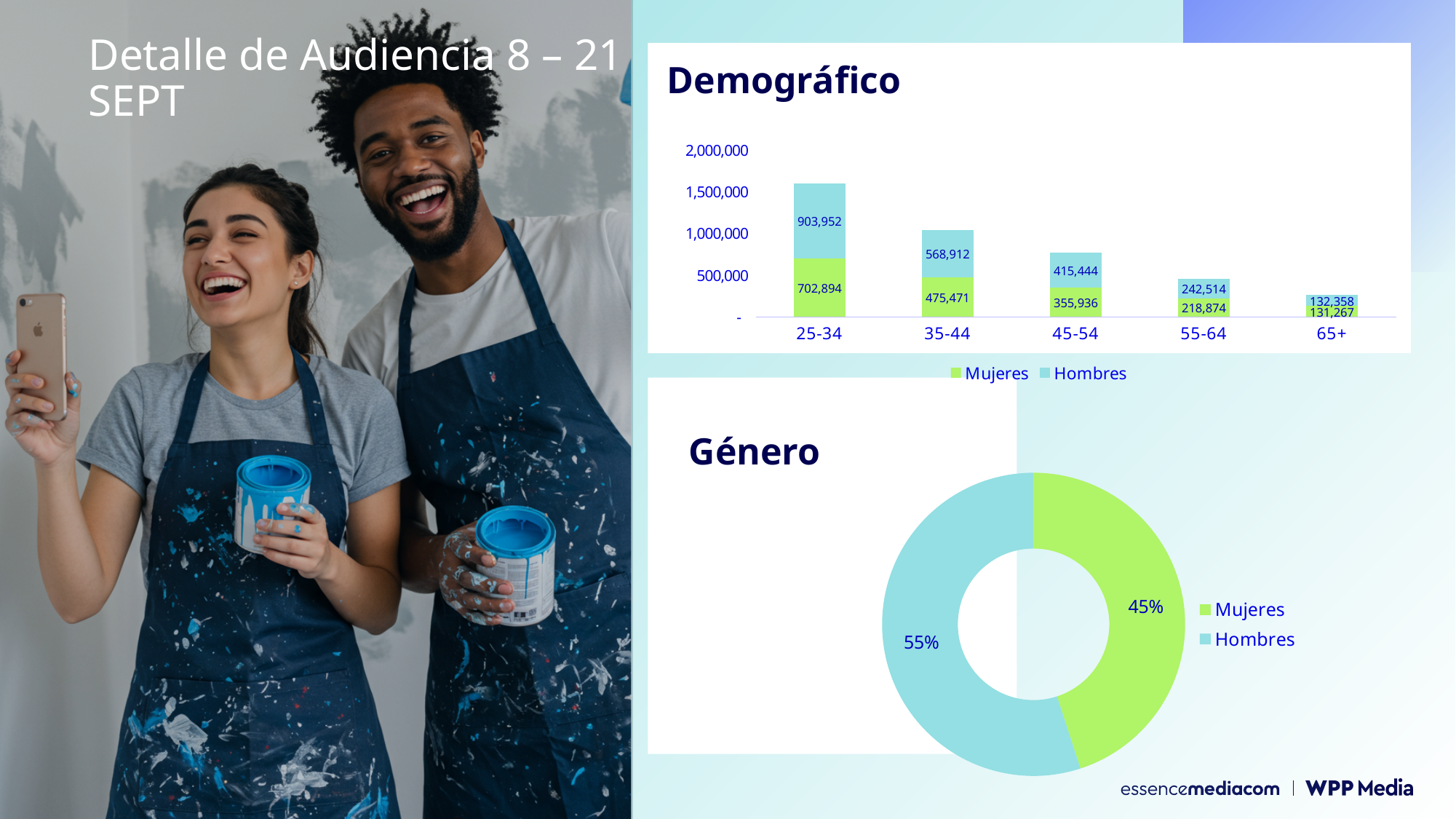
In the Demográfico chart, which age group has the lowest Hombres value? 65+ In the Demográfico chart, what is the total of the stacked bar for the 55-64 age group? 461,388 What kind of chart is the Género chart? Donut chart How many series does the legend of the Demográfico chart list? 2 In the Demográfico chart, what is the difference between the Hombres and Mujeres values for the 35-44 age group? 93,441 In the Demográfico chart, how many age groups are shown on the x axis? 5 In the Demográfico chart, do the stacked bar totals rise or fall as the age groups increase along the x axis? fall In the Demográfico chart, is the Hombres value for 45-54 larger or smaller than the Mujeres value for 35-44? smaller In the Demográfico chart, what is the Hombres value for the 25-34 age group? 903,952 In the Demográfico chart, what is the Mujeres value for the 45-54 age group? 355,936 In the Género chart, what share of the audience is Hombres? 55% In the Demográfico chart, which age group has the highest Mujeres value? 25-34